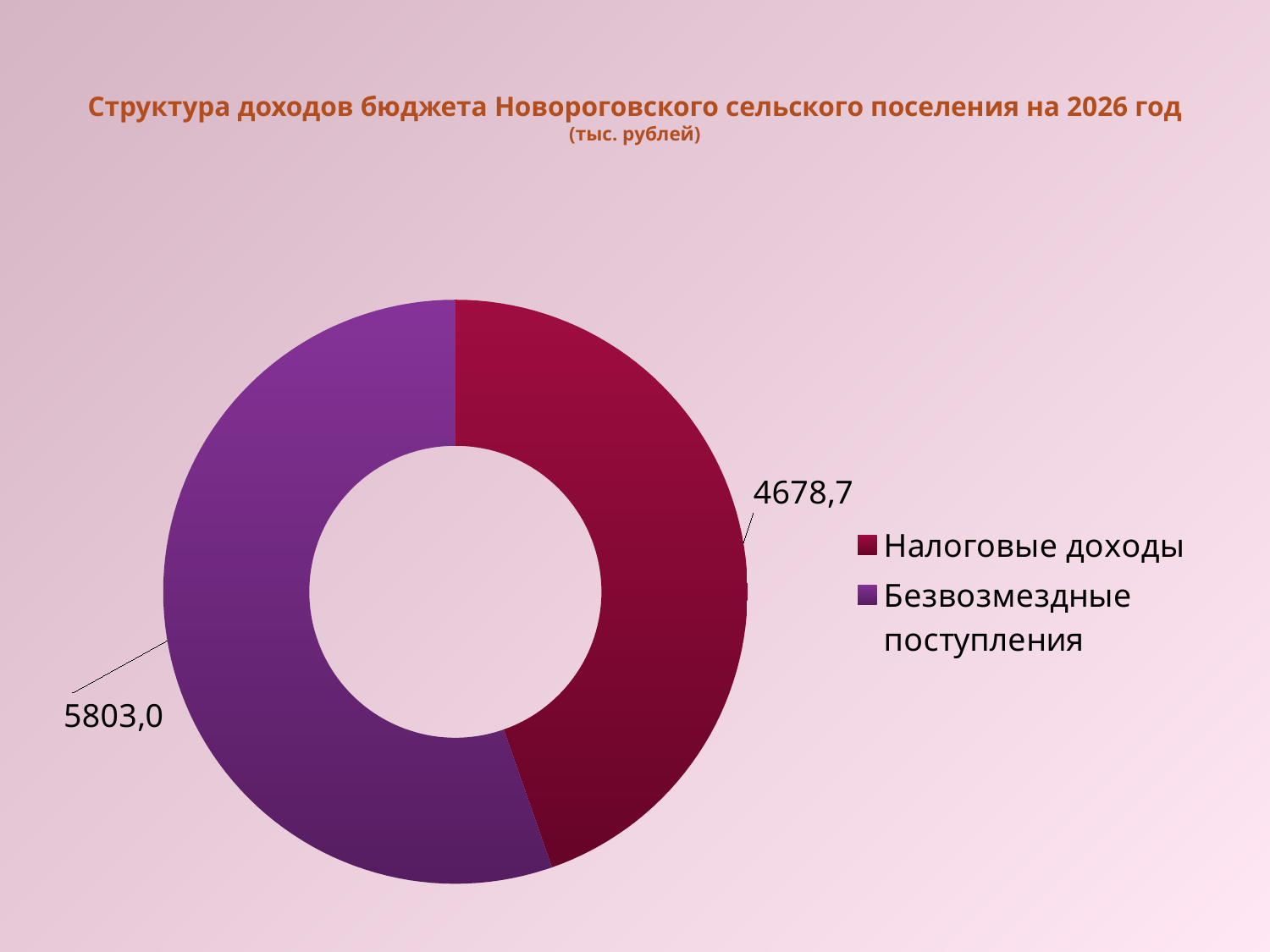
What kind of chart is shown on the slide? doughnut chart Which category has the largest value? Безвозмездные поступления What unit is given in the chart title? тыс. рублей How many entries does the legend list? 2 How many categories does the chart show? 2 What is the value for Налоговые доходы? 4678,7 What is the difference between Безвозмездные поступления and Налоговые доходы? 1124,3 Which colour represents Налоговые доходы? dark red Which category has the smallest value? Налоговые доходы What is the total of the two values shown on the chart? 10481,7 Which is larger, Налоговые доходы or Безвозмездные поступления? Безвозмездные поступления What is the value for Безвозмездные поступления? 5803,0